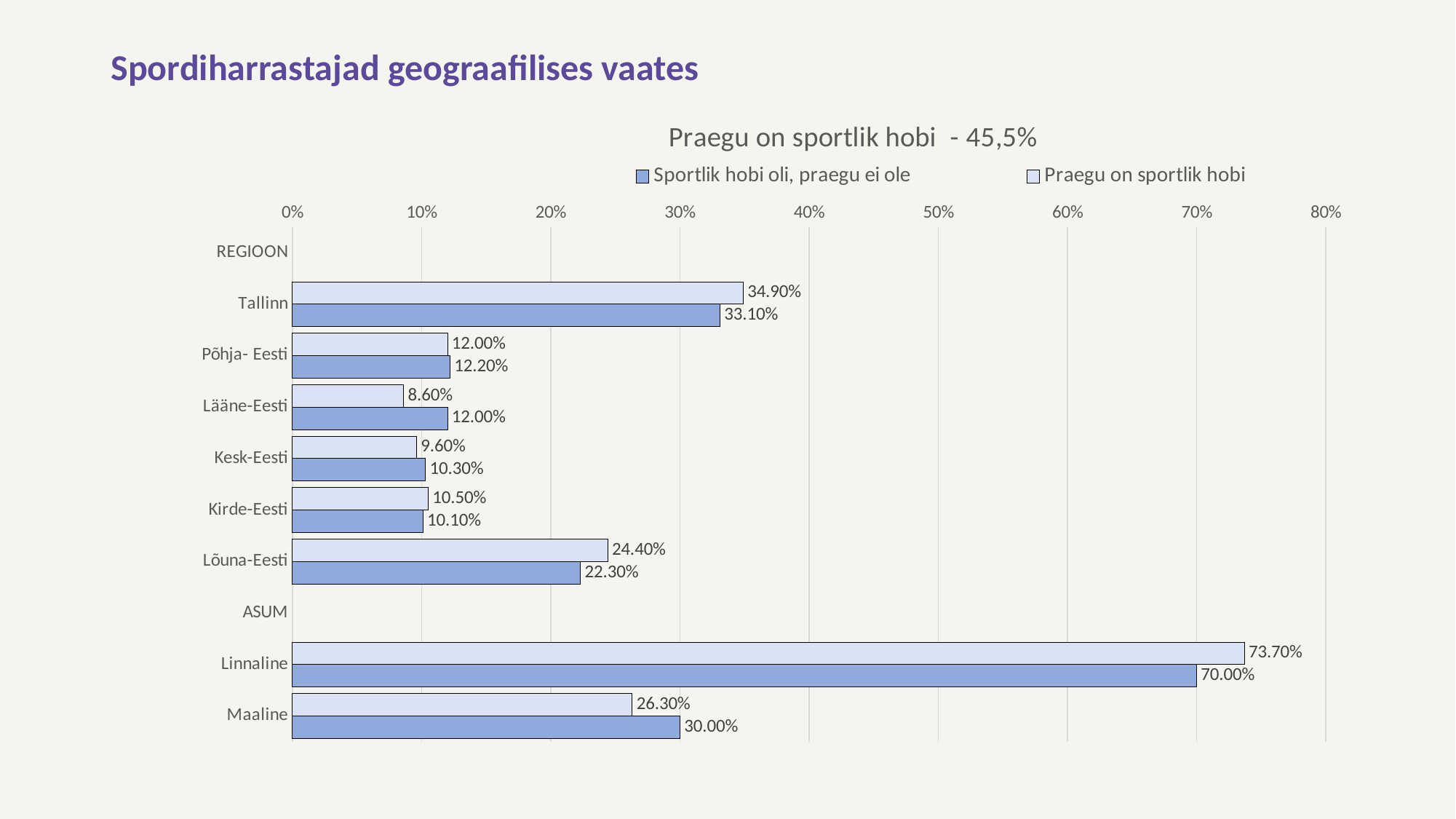
What kind of chart is shown on the slide? bar chart Is the value for Linnaline in the 'Praegu on sportlik hobi' series greater or less than 70%? greater How many regions are listed under the REGIOON group? 6 Which category has the highest value in the 'Praegu on sportlik hobi' series? Linnaline Which category has the lowest value in the 'Praegu on sportlik hobi' series? Lääne-Eesti How many series does the legend list? 2 What is the value for Tallinn in the 'Praegu on sportlik hobi' series? 34.90% What is the difference between the 'Praegu on sportlik hobi' and 'Sportlik hobi oli, praegu ei ole' values for Maaline? 3.70% For Lõuna-Eesti, which series has the larger value: 'Praegu on sportlik hobi' or 'Sportlik hobi oli, praegu ei ole'? Praegu on sportlik hobi What is the value for Lääne-Eesti in the 'Praegu on sportlik hobi' series? 8.60% What is the value for Linnaline in the 'Sportlik hobi oli, praegu ei ole' series? 70.00% What is the title of the chart? Praegu on sportlik hobi - 45,5%